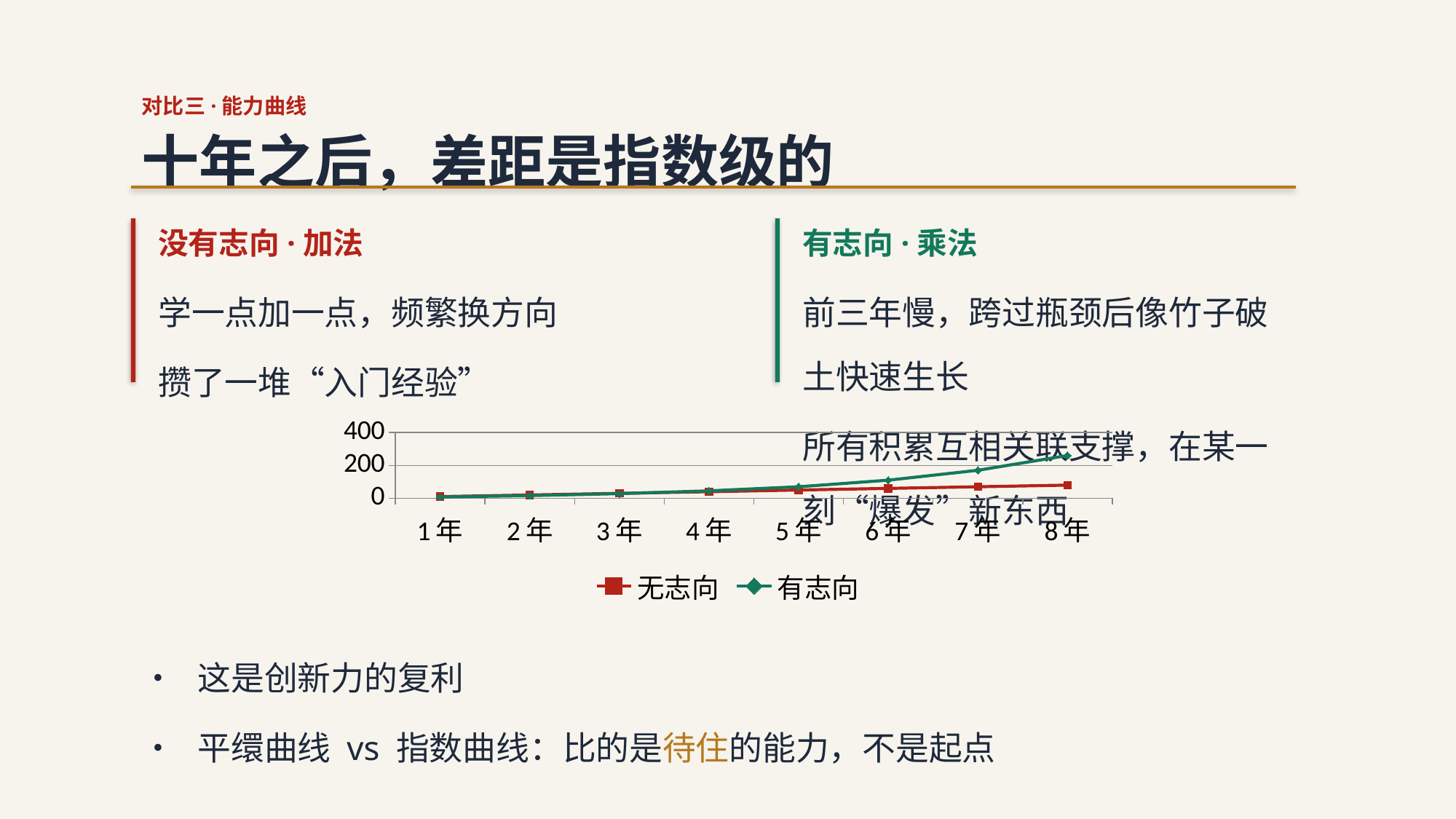
Is the value for 有志向 at 8年 greater or less than 200? greater How many series does the chart's legend list? 2 At which year does the 有志向 series reach its highest value? 8年 Which two series are listed in the chart's legend? 无志向 and 有志向 At 8年, which series has the larger value, 无志向 or 有志向? 有志向 Which series shows the steeper increase in the later years, 无志向 or 有志向? 有志向 What colour is the 有志向 line in the chart? green Does the 有志向 line rise or fall from 1年 to 8年? rise Is the value for 有志向 at 6年 greater or less than 200? less What kind of chart is shown on the slide? line chart Is the value for 无志向 at 8年 greater or less than 200? less How many points are plotted along the x axis of the chart? 8